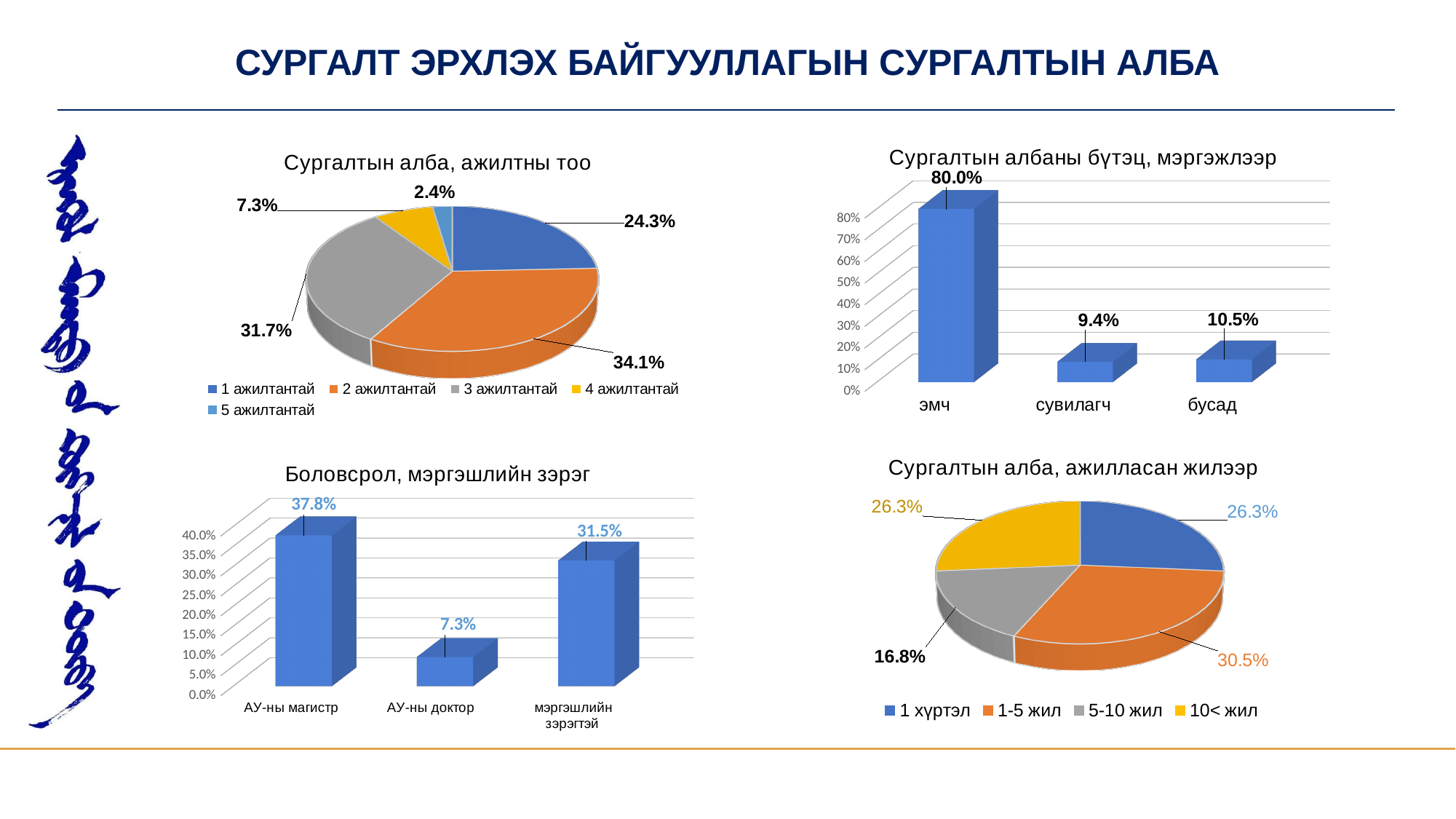
In the chart titled "Боловсрол, мэргэшлийн зэрэг", which category has the highest value? АУ-ны магистр In the chart titled "Сургалтын алба, ажилтны тоо", how many entries does the legend list? 5 In the chart titled "Боловсрол, мэргэшлийн зэрэг", what kind of chart is it? bar chart In the chart titled "Сургалтын албаны бүтэц, мэргэжлээр", what is the value for эмч? 80.0% In the chart titled "Сургалтын алба, ажилласан жилээр", which is larger, 1-5 жил or 5-10 жил? 1-5 жил In the chart titled "Сургалтын алба, ажилтны тоо", what share does 2 ажилтантай have? 34.1% In the chart titled "Боловсрол, мэргэшлийн зэрэг", how many categories are shown on the x axis? 3 In the chart titled "Боловсрол, мэргэшлийн зэрэг", what is the value for АУ-ны доктор? 7.3% In the chart titled "Сургалтын алба, ажилласан жилээр", what share does 5-10 жил have? 16.8% In the chart titled "Сургалтын албаны бүтэц, мэргэжлээр", what is the difference between the values for эмч and бусад? 69.5% In the chart titled "Сургалтын албаны бүтэц, мэргэжлээр", which category has the lowest value? сувилагч In the chart titled "Сургалтын алба, ажилтны тоо", which slice is the smallest? 5 ажилтантай